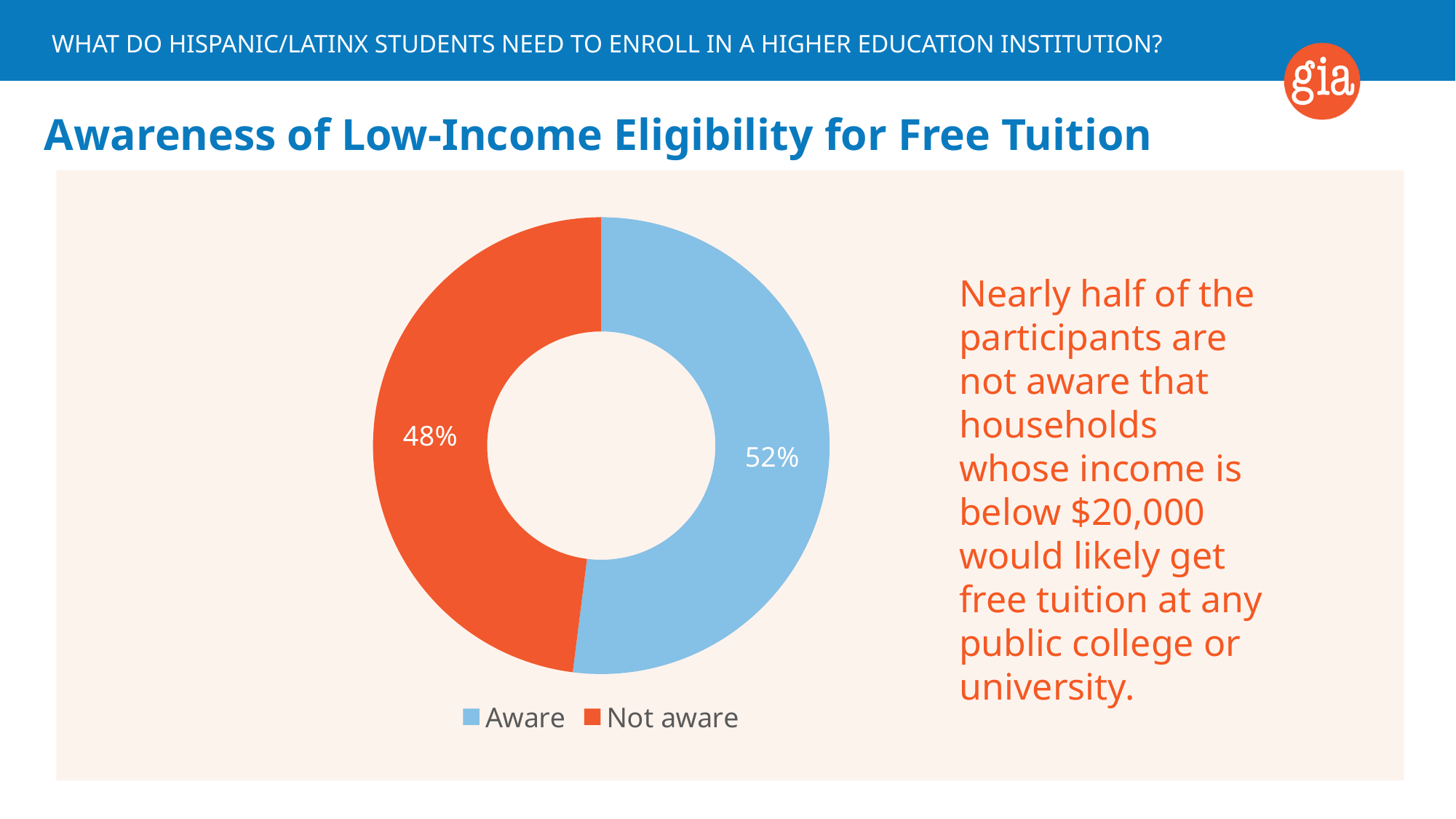
What share of the pie does the Not aware slice represent? 48% Is the Aware slice larger or smaller than the Not aware slice? larger What is the difference in percentage points between the Aware and Not aware slices? 4 What is the title of the chart on the slide? Awareness of Low-Income Eligibility for Free Tuition What percentage of participants are not aware of low-income eligibility for free tuition? 48% Which category has the smaller share of the pie? Not aware What percentage of participants are aware of low-income eligibility for free tuition? 52% What colour is the Not aware slice? orange How many slices does the pie chart have? 2 How many entries does the legend list? 2 Which category has the larger share of the pie, Aware or Not aware? Aware What kind of chart is shown on the slide? doughnut chart